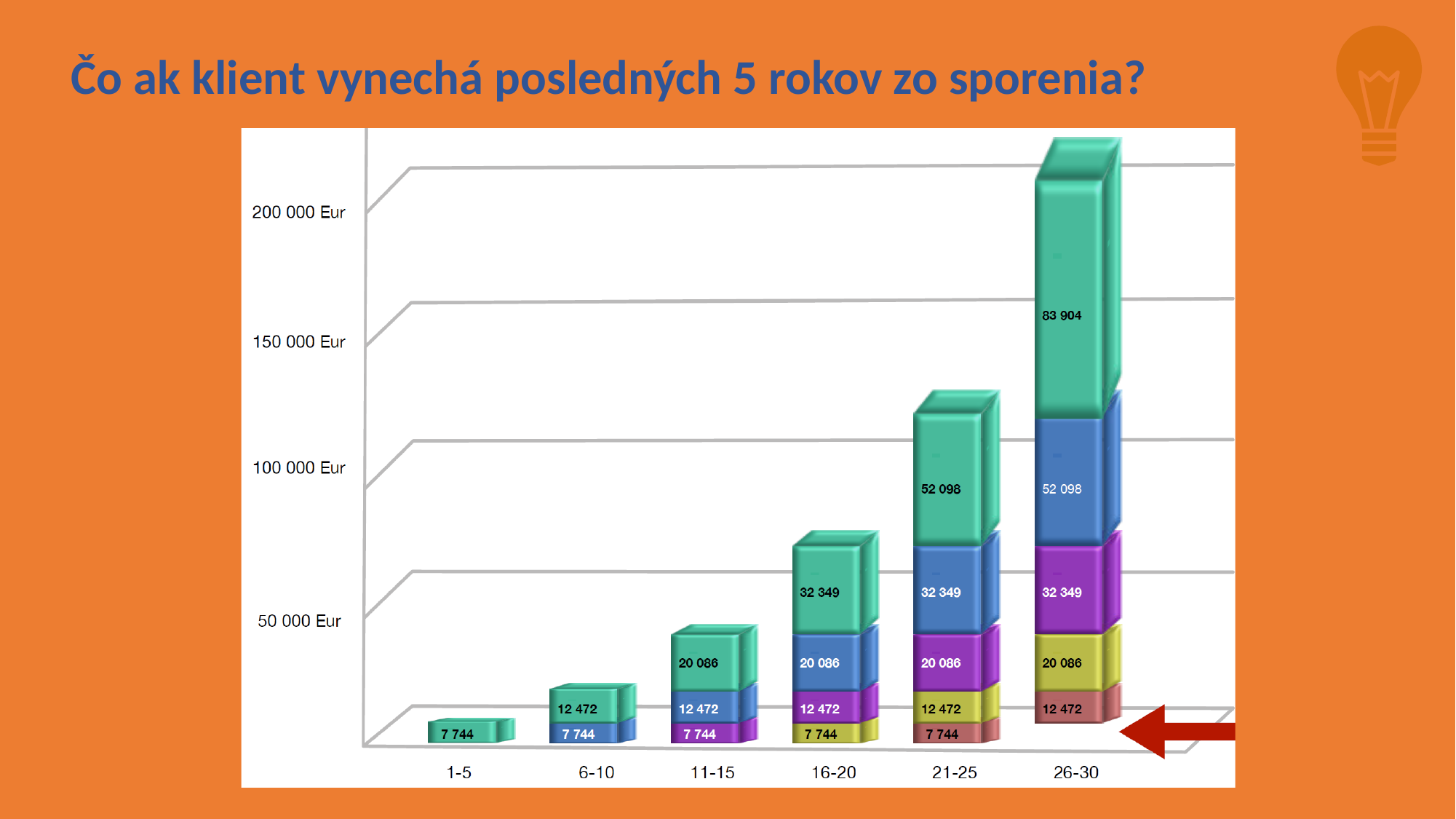
What is the value of the bottom segment of the 26-30 bar? 12 472 What is the total of the 6-10 stacked bar? 20 216 What is the total of the 11-15 stacked bar? 40 302 How many categories are shown on the x axis? 6 Which category has the shortest stacked bar? 1-5 What is the difference between the top segment of the 26-30 bar (83 904) and the top segment of the 21-25 bar (52 098)? 31 806 What kind of chart is shown on the slide? stacked bar chart Is the total height of the 21-25 bar greater or less than 100 000 Eur? greater Do the stacked bar totals rise or fall from 1-5 to 26-30 along the x axis? rise What is the value of the single segment in the 1-5 bar? 7 744 What is the value of the top segment of the 26-30 bar? 83 904 Which category has the tallest stacked bar? 26-30